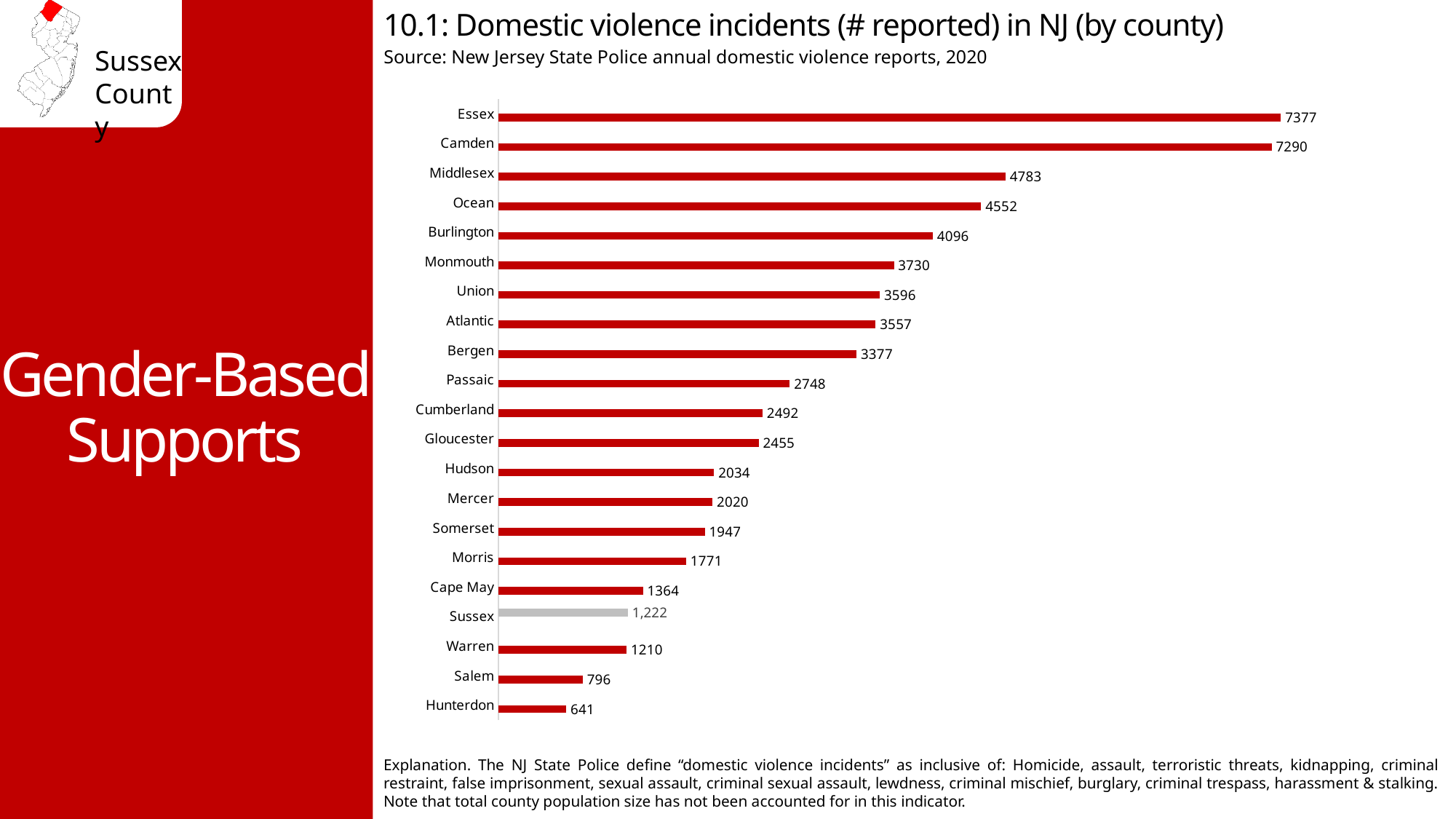
Which county has more reported incidents, Salem or Warren? Warren What is the number of domestic violence incidents reported for Essex? 7377 What is the difference between the values for Middlesex and Ocean? 231 Which county has more reported incidents, Hudson or Mercer? Hudson What is the difference between the values for Essex and Camden? 87 Which county has the lowest number of reported domestic violence incidents? Hunterdon What is the value shown for Sussex? 1,222 How many domestic violence incidents were reported in Monmouth? 3730 How many counties are shown in the chart? 21 What kind of chart is shown on the slide? Bar chart Which county has the highest number of reported domestic violence incidents? Essex Which county's bar is shown in grey instead of red? Sussex